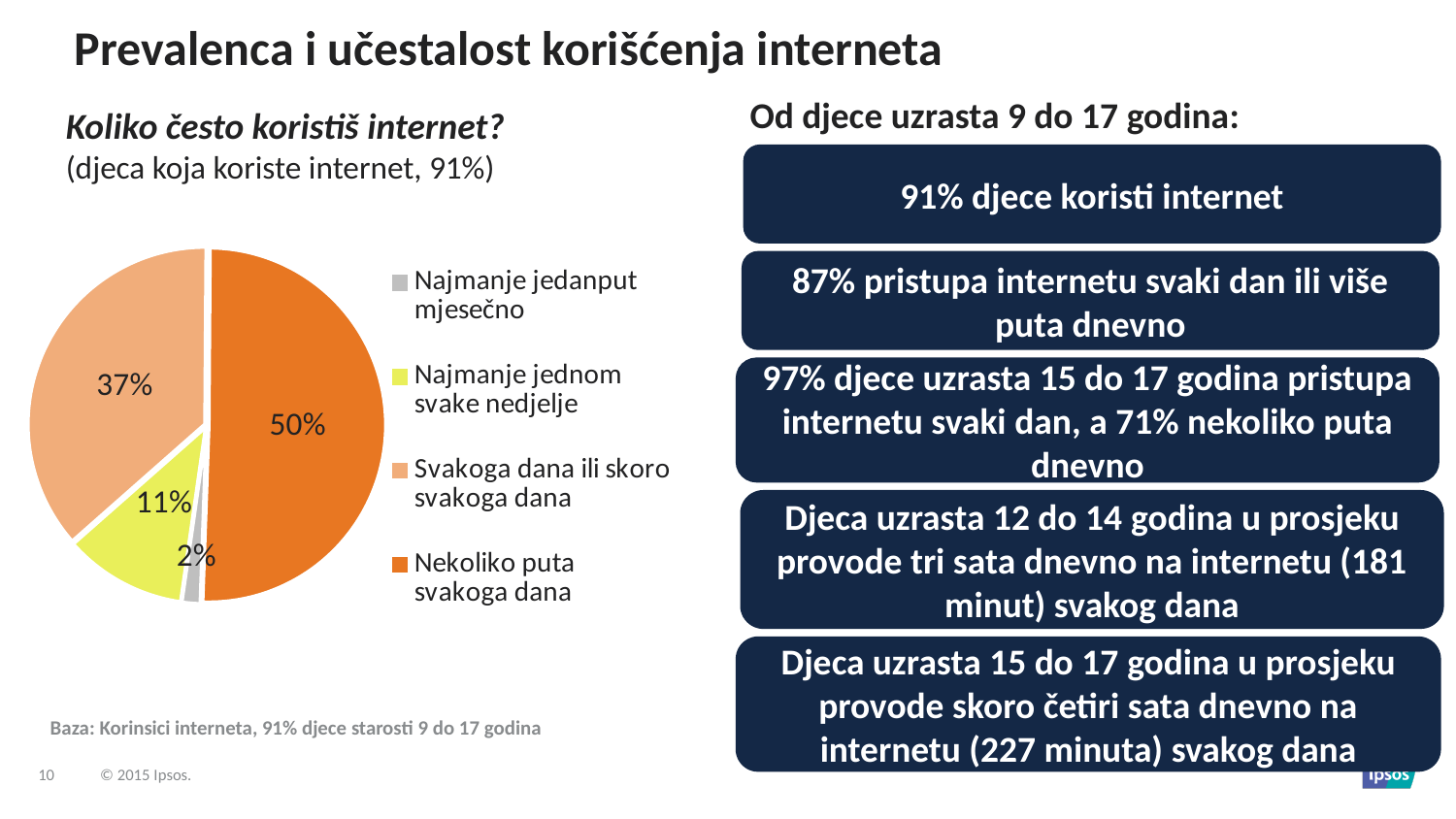
Which category has the largest slice of the pie? Nekoliko puta svakoga dana What colour is the slice for "Najmanje jednom svake nedjelje"? yellow What share of the pie is labelled "Nekoliko puta svakoga dana"? 50% What share of the pie is labelled "Najmanje jednom svake nedjelje"? 11% How many entries does the legend of the pie chart list? 4 What is the difference between the "Nekoliko puta svakoga dana" slice and the "Svakoga dana ili skoro svakoga dana" slice? 13% What share of the pie is labelled "Svakoga dana ili skoro svakoga dana"? 37% What kind of chart is shown on the slide? pie chart How many slices does the pie chart have? 4 Which category has the smallest slice of the pie? Najmanje jedanput mjesečno Which is larger: the "Najmanje jednom svake nedjelje" slice or the "Najmanje jedanput mjesečno" slice? Najmanje jednom svake nedjelje